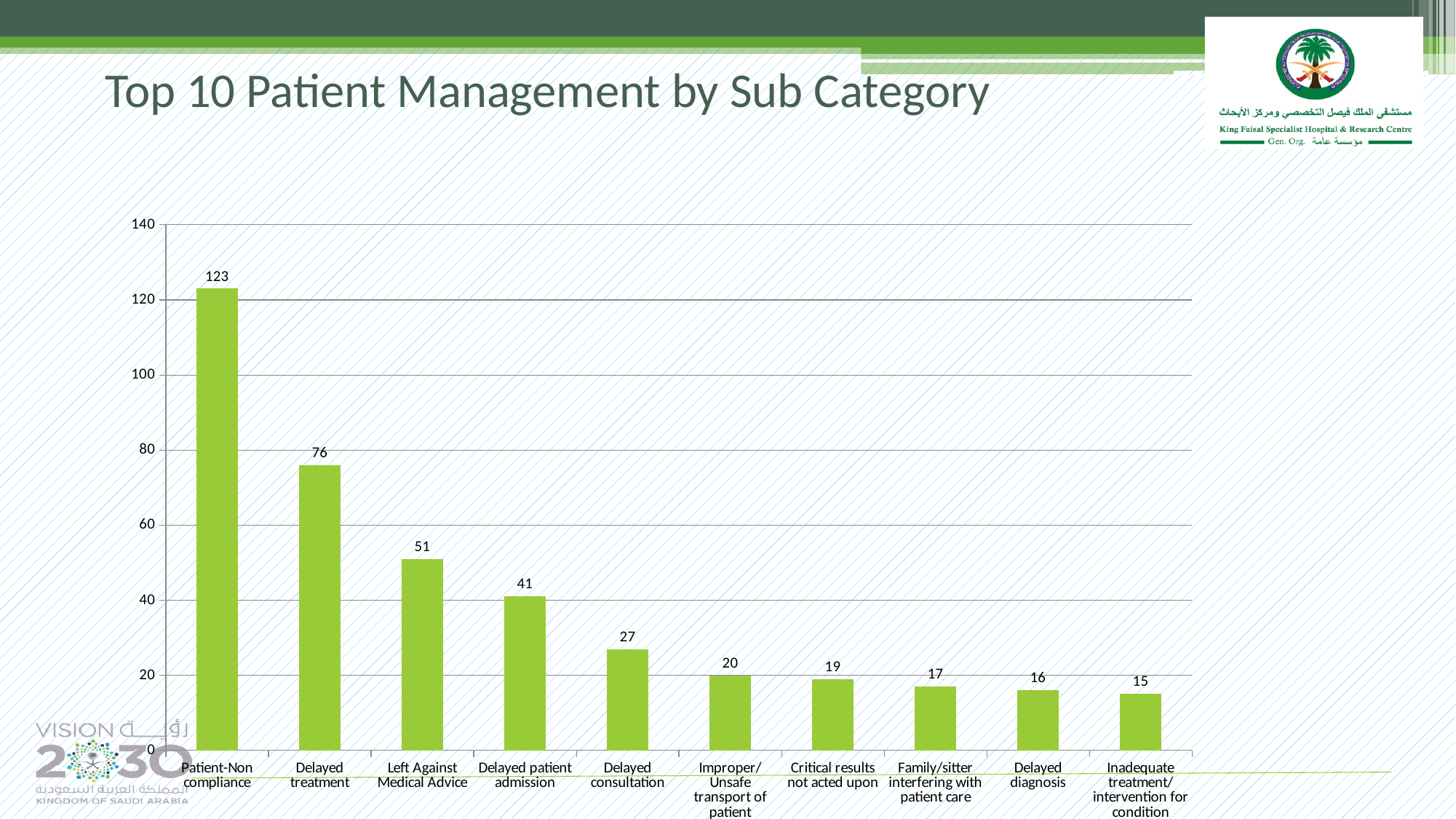
What is the value for Patient-Non compliance? 123 What is the value for Critical results not acted upon? 19 What is the title of the chart? Top 10 Patient Management by Sub Category What is the value for Delayed consultation? 27 How many sub categories are shown on the chart? 10 Which sub category has the highest value? Patient-Non compliance What is the difference between the values for Delayed treatment and Left Against Medical Advice? 25 Which is larger, the value for Delayed patient admission or the value for Delayed consultation? Delayed patient admission Is the value for Delayed treatment greater or less than 80? less Which sub category has the lowest value? Inadequate treatment/intervention for condition Do the values rise or fall from left to right along the x axis? fall What kind of chart is shown on the slide? bar chart